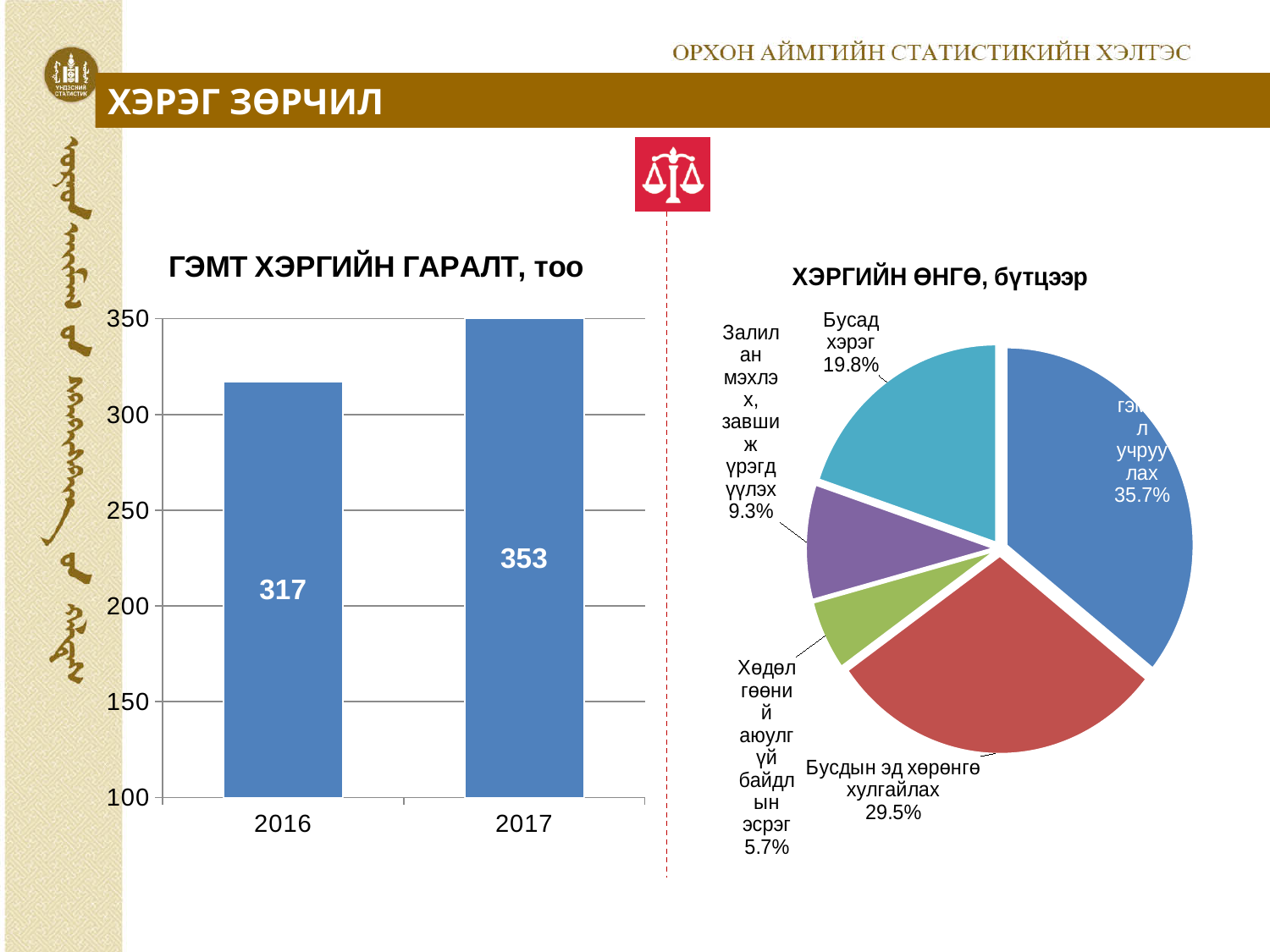
In the bar chart 'ГЭМТ ХЭРГИЙН ГАРАЛТ, тоо', do the values rise or fall from 2016 to 2017? rise How many categories are shown in the bar chart 'ГЭМТ ХЭРГИЙН ГАРАЛТ, тоо'? 2 In the pie chart 'ХЭРГИЙН ӨНГӨ, бүтцээр', what share is 'Бусад хэрэг'? 19.8% In the pie chart 'ХЭРГИЙН ӨНГӨ, бүтцээр', which slice is the smallest? Хөдөлгөөний аюулгүй байдлын эсрэг In the bar chart 'ГЭМТ ХЭРГИЙН ГАРАЛТ, тоо', what is the value for 2016? 317 In the bar chart 'ГЭМТ ХЭРГИЙН ГАРАЛТ, тоо', which year has the higher value? 2017 In the bar chart 'ГЭМТ ХЭРГИЙН ГАРАЛТ, тоо', what is the value for 2017? 353 How many slices does the pie chart 'ХЭРГИЙН ӨНГӨ, бүтцээр' have? 5 What type of chart is 'ГЭМТ ХЭРГИЙН ГАРАЛТ, тоо'? bar chart In the pie chart 'ХЭРГИЙН ӨНГӨ, бүтцээр', what share is 'Хөдөлгөөний аюулгүй байдлын эсрэг'? 5.7% In the bar chart 'ГЭМТ ХЭРГИЙН ГАРАЛТ, тоо', by how much did the value increase from 2016 to 2017? 36 In the pie chart 'ХЭРГИЙН ӨНГӨ, бүтцээр', what share is 'Бусдын эд хөрөнгө хулгайлах'? 29.5%